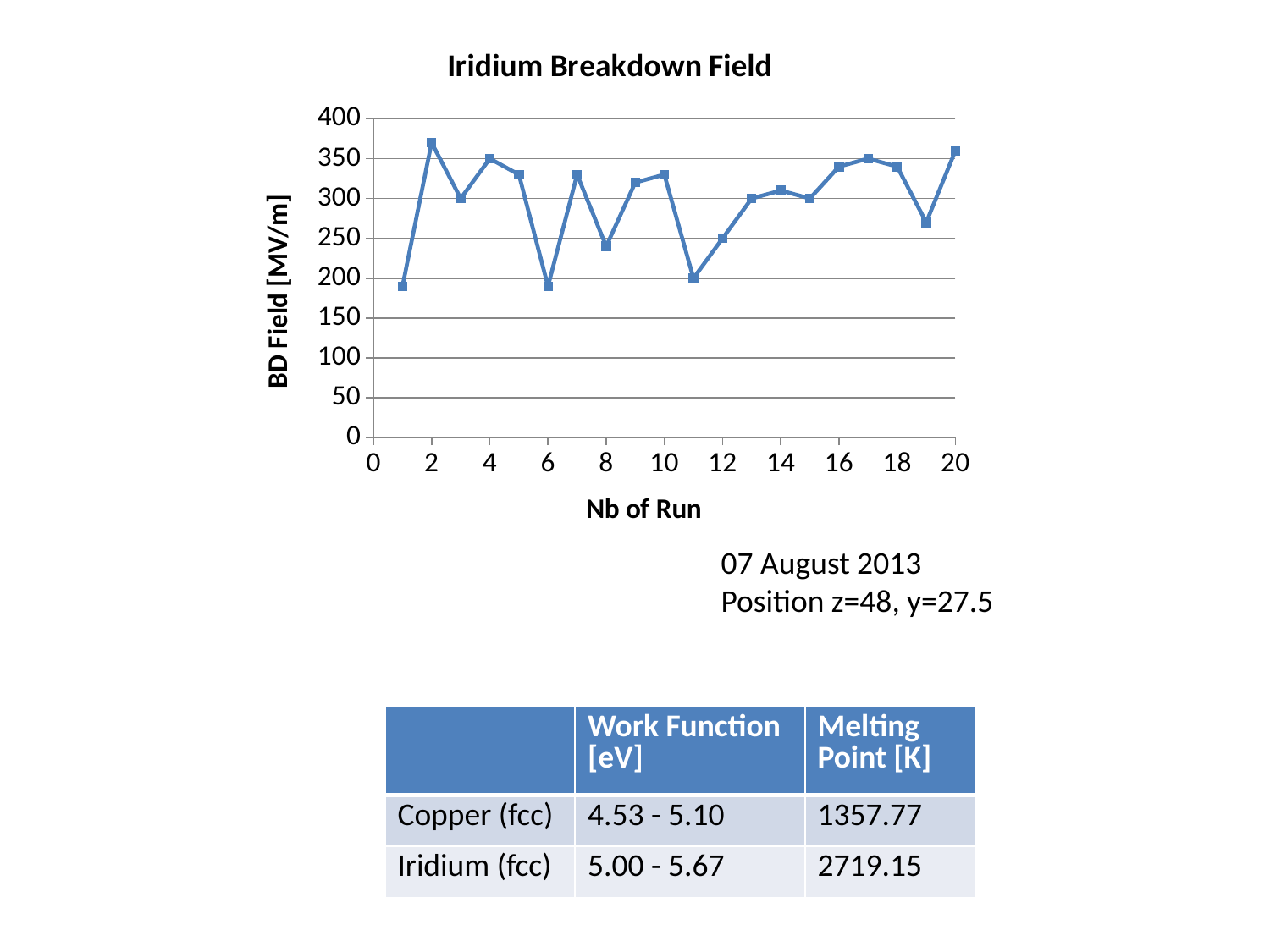
Is the BD Field value for run 8 greater or less than 300? less Do the BD Field values generally rise or fall from run 11 to run 17? rise Is the BD Field value for run 6 greater or less than 250? less Is the BD Field value for run 17 greater or less than 300? greater What kind of chart is shown on the slide? line chart What is the label of the y axis of the chart? BD Field [MV/m] Which has the higher BD Field value, run 17 or run 19? run 17 What is the title of the chart? Iridium Breakdown Field Which has the higher BD Field value, run 2 or run 6? run 2 How many data points are plotted on the chart? 20